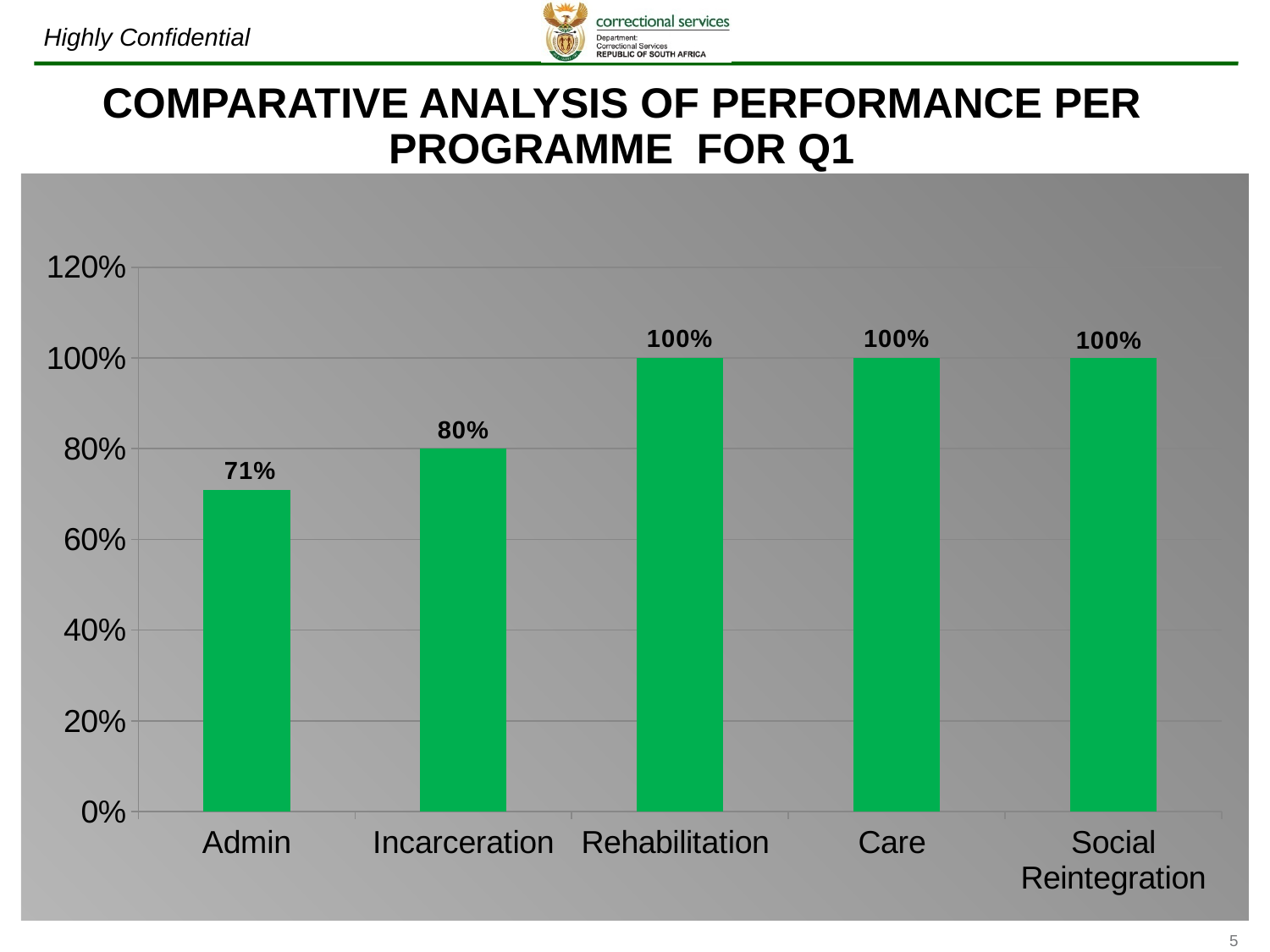
What is the value for Incarceration? 80% Which programme has the lowest value? Admin What is the value for Care? 100% What kind of chart is shown on the slide? bar chart How many programmes are shown on the x axis? 5 How many programmes have a value of 100%? 3 What is the value for Admin? 71% What is the difference between the values for Rehabilitation and Incarceration? 20% Which is larger, the value for Admin or the value for Incarceration? Incarceration What is the difference between the values for Incarceration and Admin? 9% Is the value for Admin greater or less than 80%? less What is the value for Social Reintegration? 100%